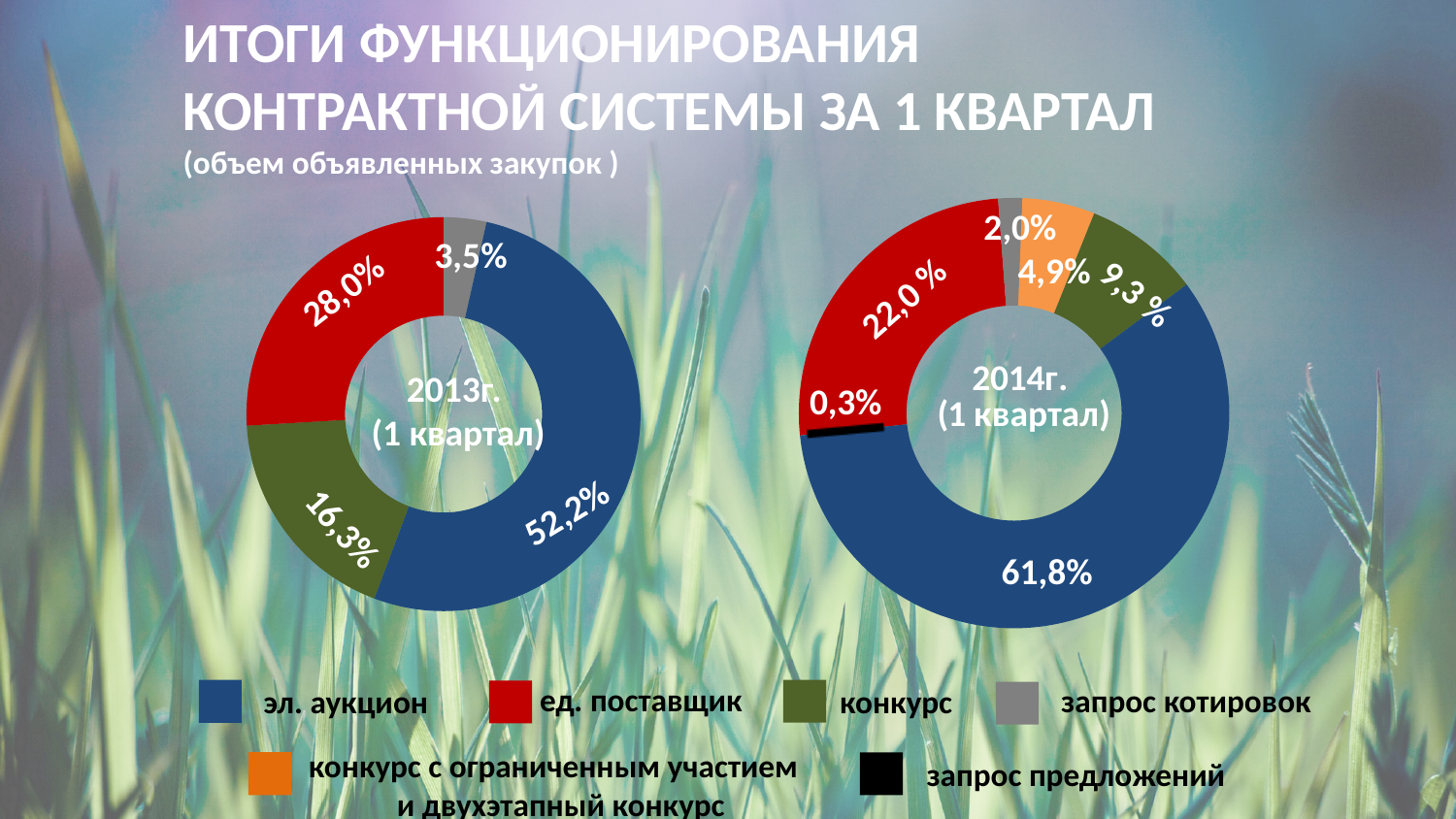
In the 2013г. (1 квартал) chart, what share does эл. аукцион have? 52,2% What is the difference between the эл. аукцион share in the 2014г. (1 квартал) chart and in the 2013г. (1 квартал) chart? 9,6 percentage points In the 2013г. (1 квартал) chart, what share does запрос котировок have? 3,5% In the 2014г. (1 квартал) chart, which category has the smallest share? запрос предложений In the 2013г. (1 квартал) chart, which category has the largest share? эл. аукцион What type of chart is used on this slide? Donut (pie) chart In the 2014г. (1 квартал) chart, what share does конкурс have? 9,3 % Which is larger: the конкурс share in the 2013г. (1 квартал) chart or in the 2014г. (1 квартал) chart? 2013г. (1 квартал) How many slices does the 2014г. (1 квартал) chart have? 6 In the 2014г. (1 квартал) chart, what share does запрос предложений have? 0,3% In the 2014г. (1 квартал) chart, what share does эл. аукцион have? 61,8% In the 2013г. (1 квартал) chart, what share does ед. поставщик have? 28,0%